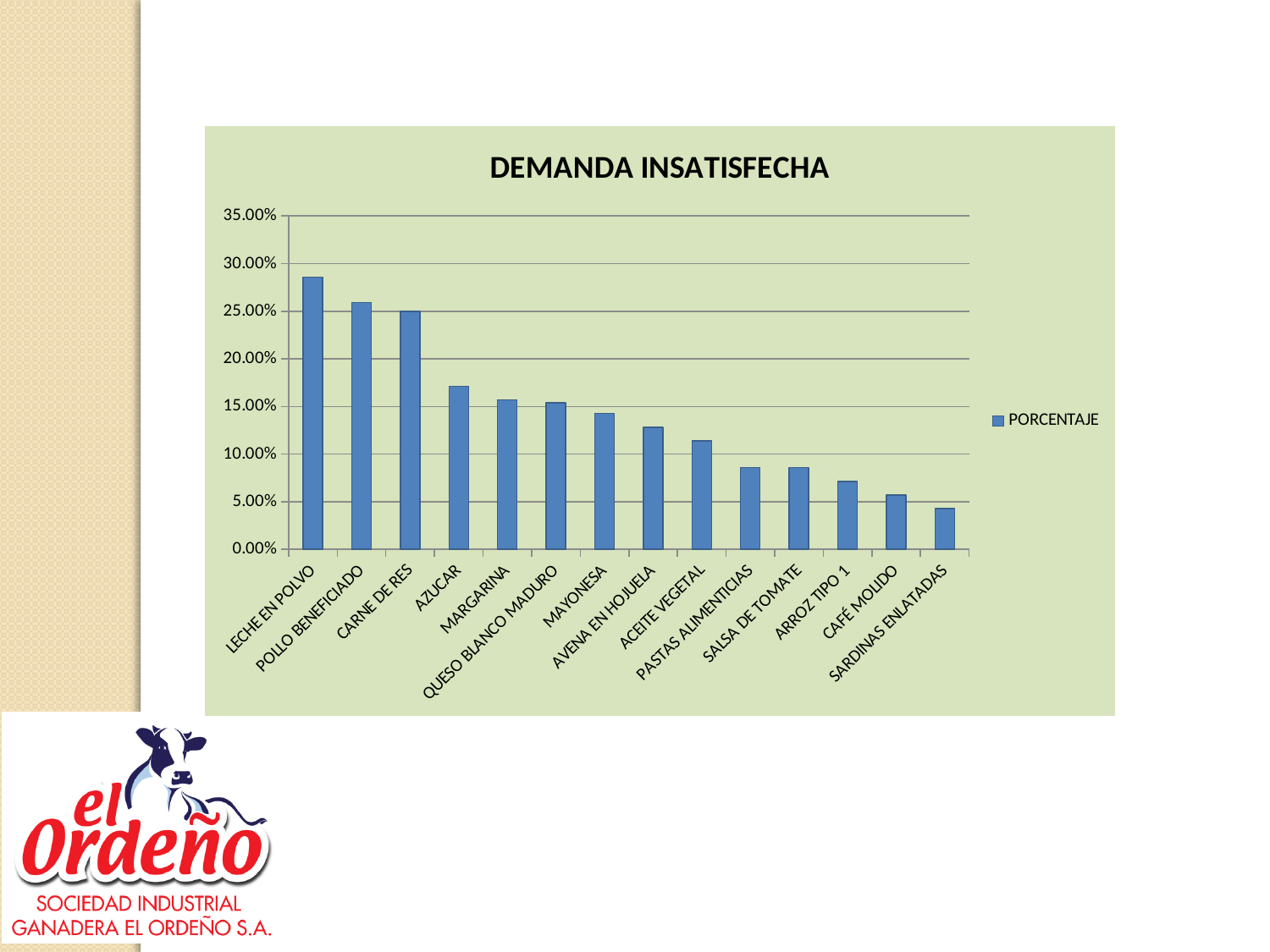
What is the name of the series shown in the legend? PORCENTAJE Which is larger, the value for MARGARINA or the value for CAFÉ MOLIDO? MARGARINA Is the value for AZUCAR greater or less than 15.00%? greater Is the value for LECHE EN POLVO greater or less than 25.00%? greater Which category has the lowest value? SARDINAS ENLATADAS How many series does the legend list? 1 Is the value for SARDINAS ENLATADAS greater or less than 5.00%? less Do the values rise or fall from left to right along the x axis? fall What type of chart is shown on the slide? bar chart Which category has the highest value? LECHE EN POLVO What is the title of the chart? DEMANDA INSATISFECHA How many categories are shown on the x axis? 14